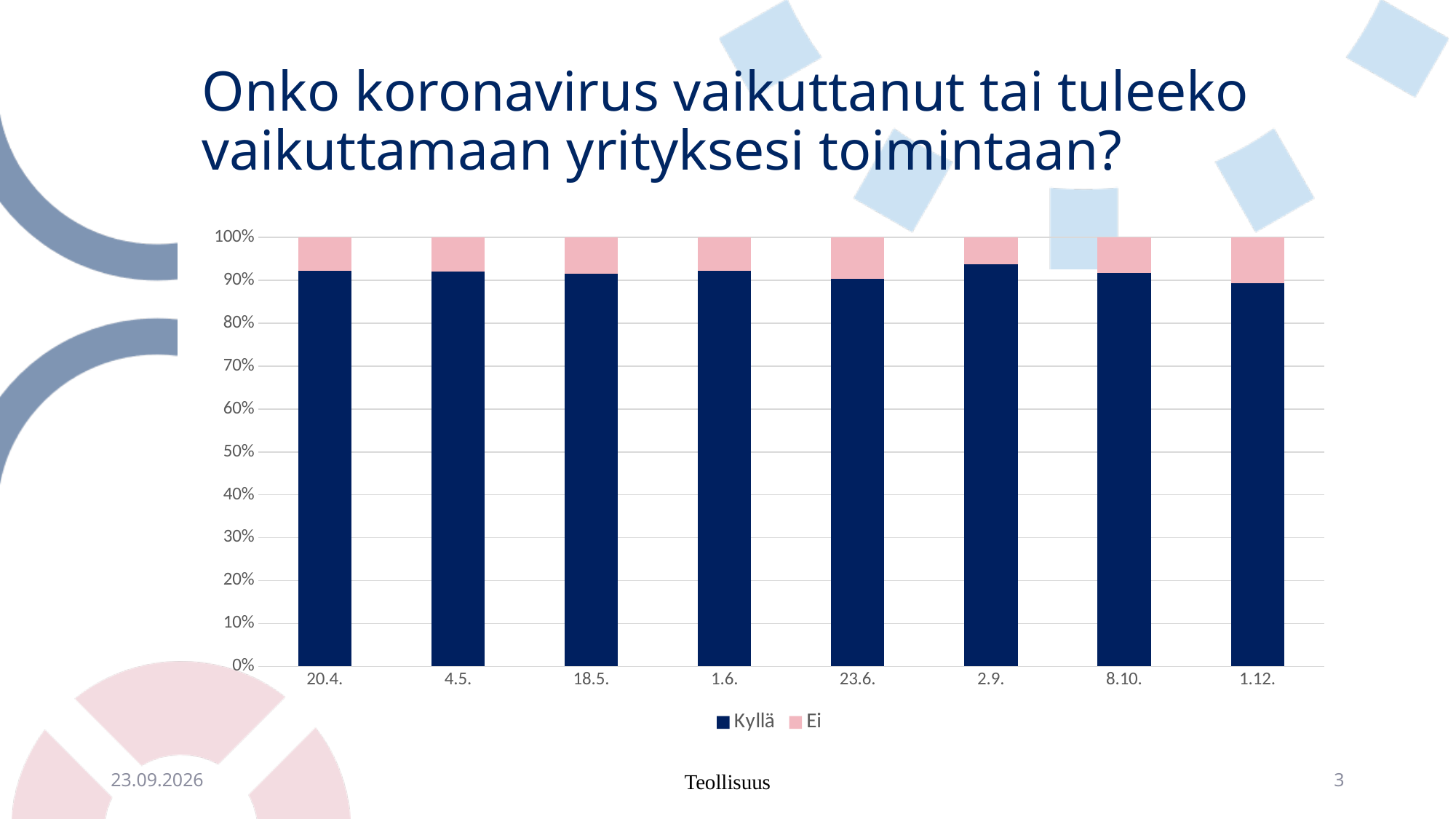
Which is larger, the Kyllä share for 2.9. or for 1.12.? 2.9. Which date has the highest Kyllä share? 2.9. What is the total of each stacked bar? 100% How many series does the legend list? 2 Is the Kyllä value for 20.4. greater or less than 80%? greater How many dates (categories) are shown on the x axis? 8 What are the two series named in the legend? Kyllä and Ei Is the Ei value for 1.12. greater or less than 20%? less Is the Kyllä value for 4.5. greater or less than 50%? greater What kind of chart is shown on the slide? Stacked bar chart Which colour represents the Kyllä series? Dark blue